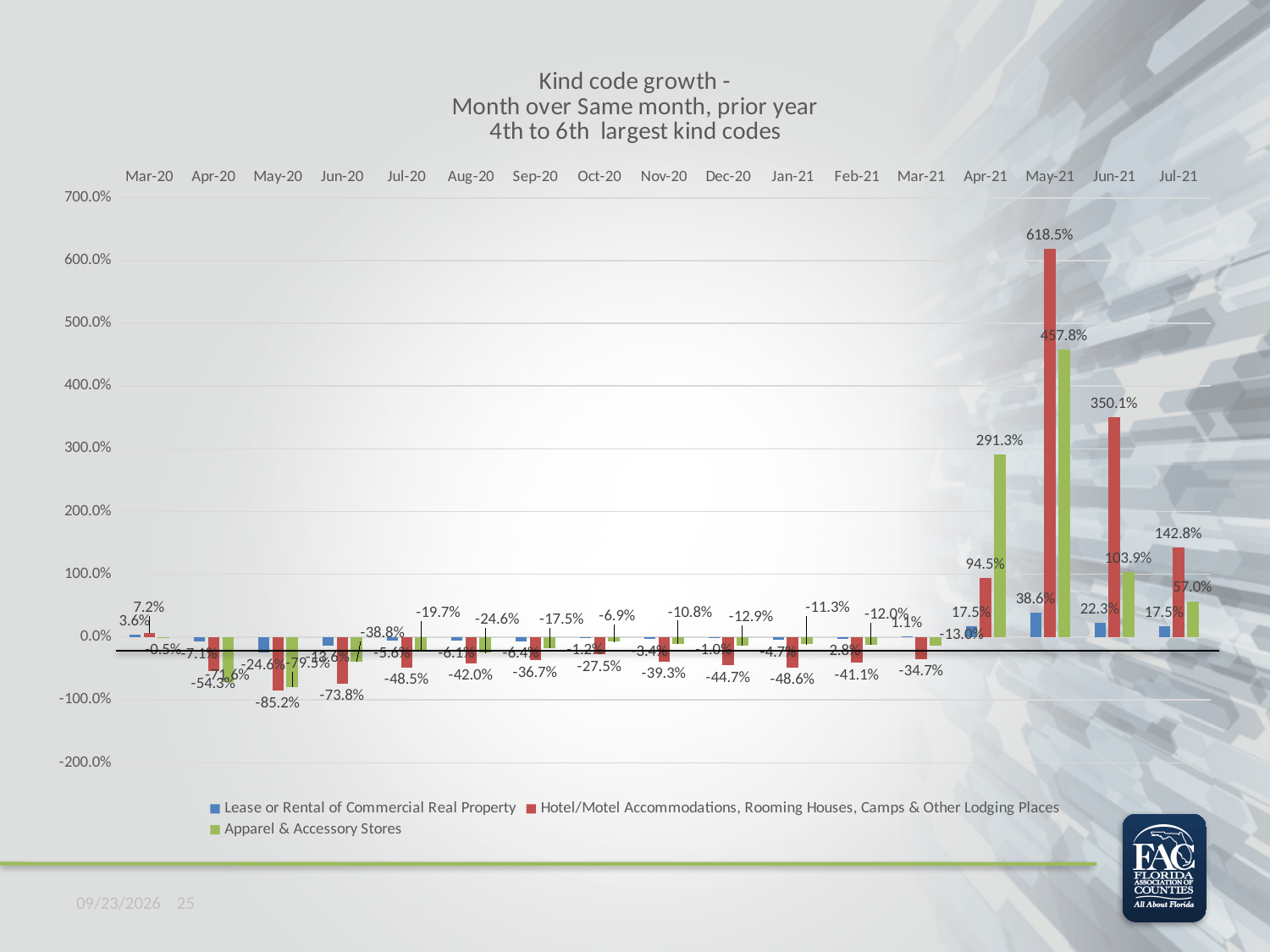
Does the value for Apparel & Accessory Stores rise or fall from May-21 to Jul-21? Fall What is the value for Apparel & Accessory Stores in Apr-21? 291.3% What is the value for Lease or Rental of Commercial Real Property in May-21? 38.6% In Apr-21, which is larger: the value for Apparel & Accessory Stores or the value for Hotel/Motel Accommodations, Rooming Houses, Camps & Other Lodging Places? Apparel & Accessory Stores How many months are shown on the x axis? 17 Which month has the highest value for Hotel/Motel Accommodations, Rooming Houses, Camps & Other Lodging Places? May-21 Which month has the lowest value for Hotel/Motel Accommodations, Rooming Houses, Camps & Other Lodging Places? May-20 What kind of chart is shown on the slide? Bar chart What is the value for Hotel/Motel Accommodations, Rooming Houses, Camps & Other Lodging Places in May-21? 618.5% What is the difference between the Hotel/Motel Accommodations value and the Apparel & Accessory Stores value in May-21? 160.7 percentage points What is the value for Hotel/Motel Accommodations, Rooming Houses, Camps & Other Lodging Places in Jun-21? 350.1% How many series does the legend list? 3